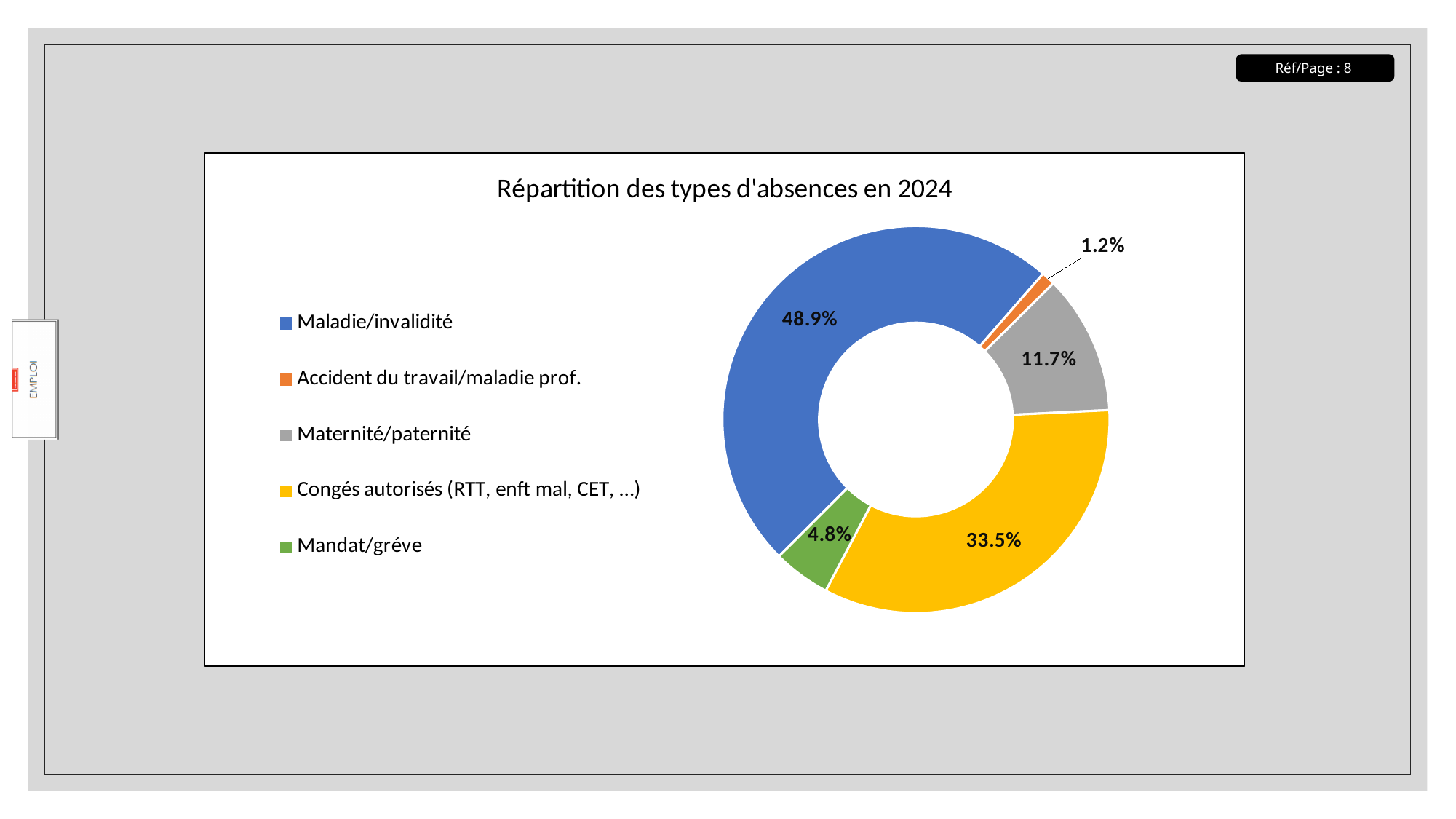
Which type of absence has the largest share? Maladie/invalidité What kind of chart is shown on the slide? Doughnut chart What is the title of the chart? Répartition des types d'absences en 2024 What share of absences is Accident du travail/maladie prof.? 1.2% What share of absences is Mandat/gréve? 4.8% How many types of absence are shown in the chart? 5 Which type of absence has the smallest share? Accident du travail/maladie prof. Which is larger: the share for Maternité/paternité or the share for Mandat/gréve? Maternité/paternité What share of absences is Maternité/paternité? 11.7% What share of absences is Congés autorisés (RTT, enft mal, CET, ...)? 33.5% What is the difference in percentage points between Maladie/invalidité and Congés autorisés (RTT, enft mal, CET, ...)? 15.4 What share of absences is Maladie/invalidité? 48.9%